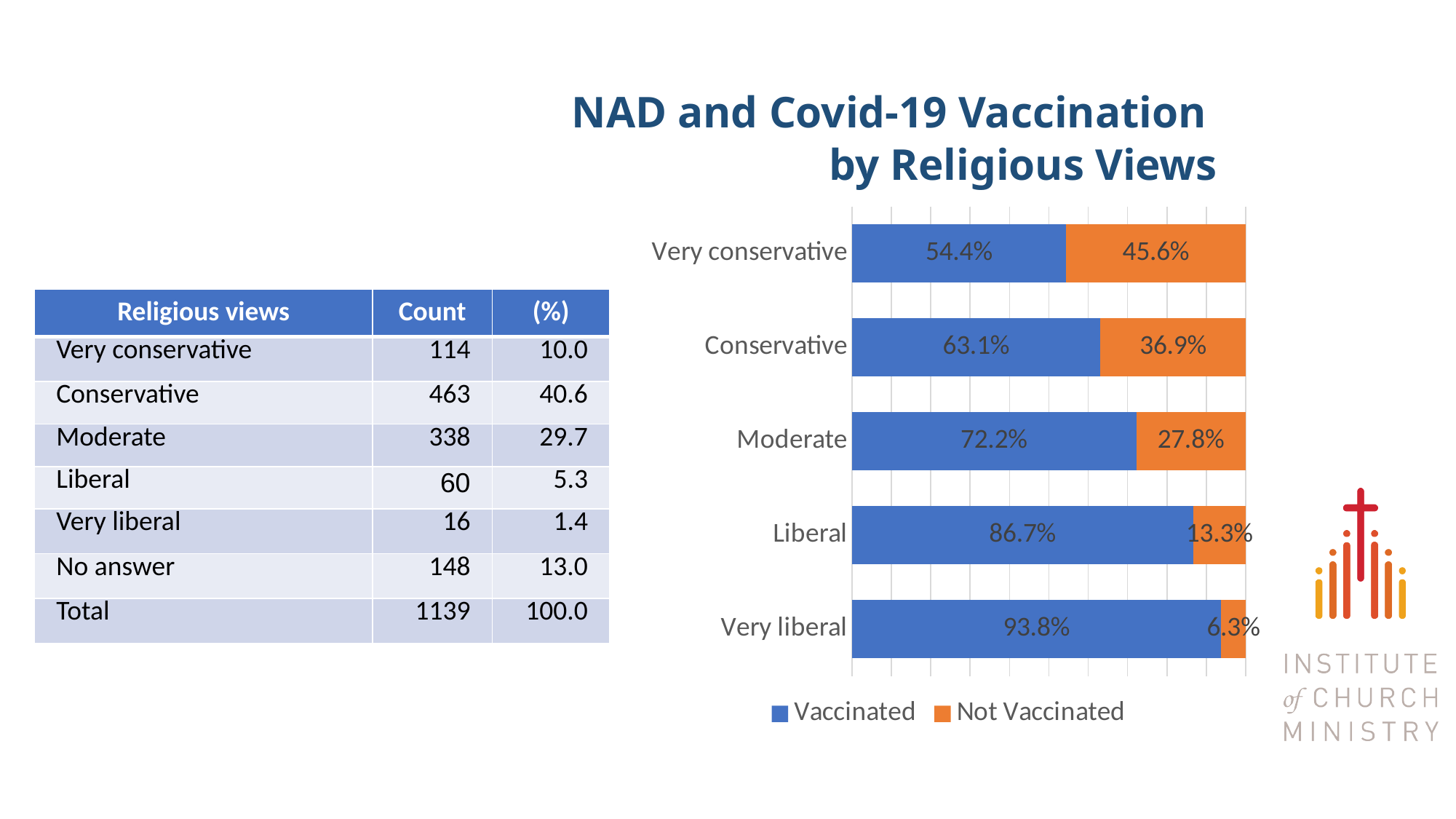
How many series does the legend list? 2 How many categories are shown on the chart? 5 What is the difference between the Vaccinated values for Conservative and Very conservative? 8.7% What is the Not Vaccinated value for Very conservative? 45.6% What is the Vaccinated value for Moderate? 72.2% Which category has the highest Vaccinated value? Very liberal What is the title of the chart? NAD and Covid-19 Vaccination by Religious Views Which is larger, the Not Vaccinated value for Conservative or for Moderate? Conservative Which category has the lowest Vaccinated value? Very conservative What is the Not Vaccinated value for Very liberal? 6.3% What kind of chart is shown? Stacked bar chart What is the Vaccinated value for Liberal? 86.7%